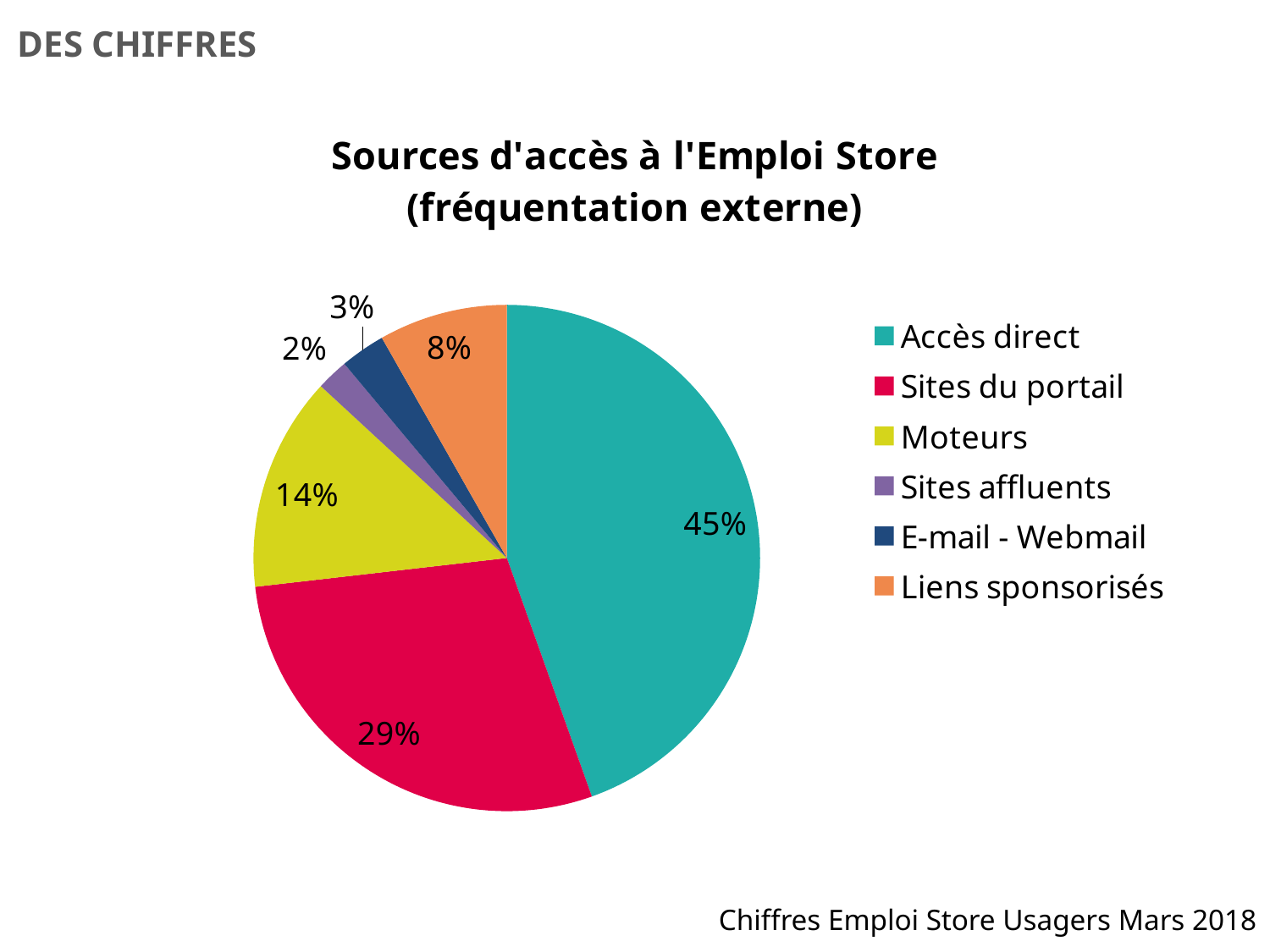
What is the value shown for Liens sponsorisés? 8% What is the value shown for Moteurs? 14% Which source has the smallest share of the pie? Sites affluents What is the value shown for E-mail - Webmail? 3% What is the difference in percentage points between Accès direct and Sites du portail? 16 Which is larger, the share for Moteurs or the share for Liens sponsorisés? Moteurs Which source has the largest share of the pie? Accès direct What is the title of the chart? Sources d'accès à l'Emploi Store (fréquentation externe) What kind of chart is shown on the slide? Pie chart What is the value shown for Sites du portail? 29% What share of the pie does Accès direct represent? 45% How many categories does the pie chart show? 6